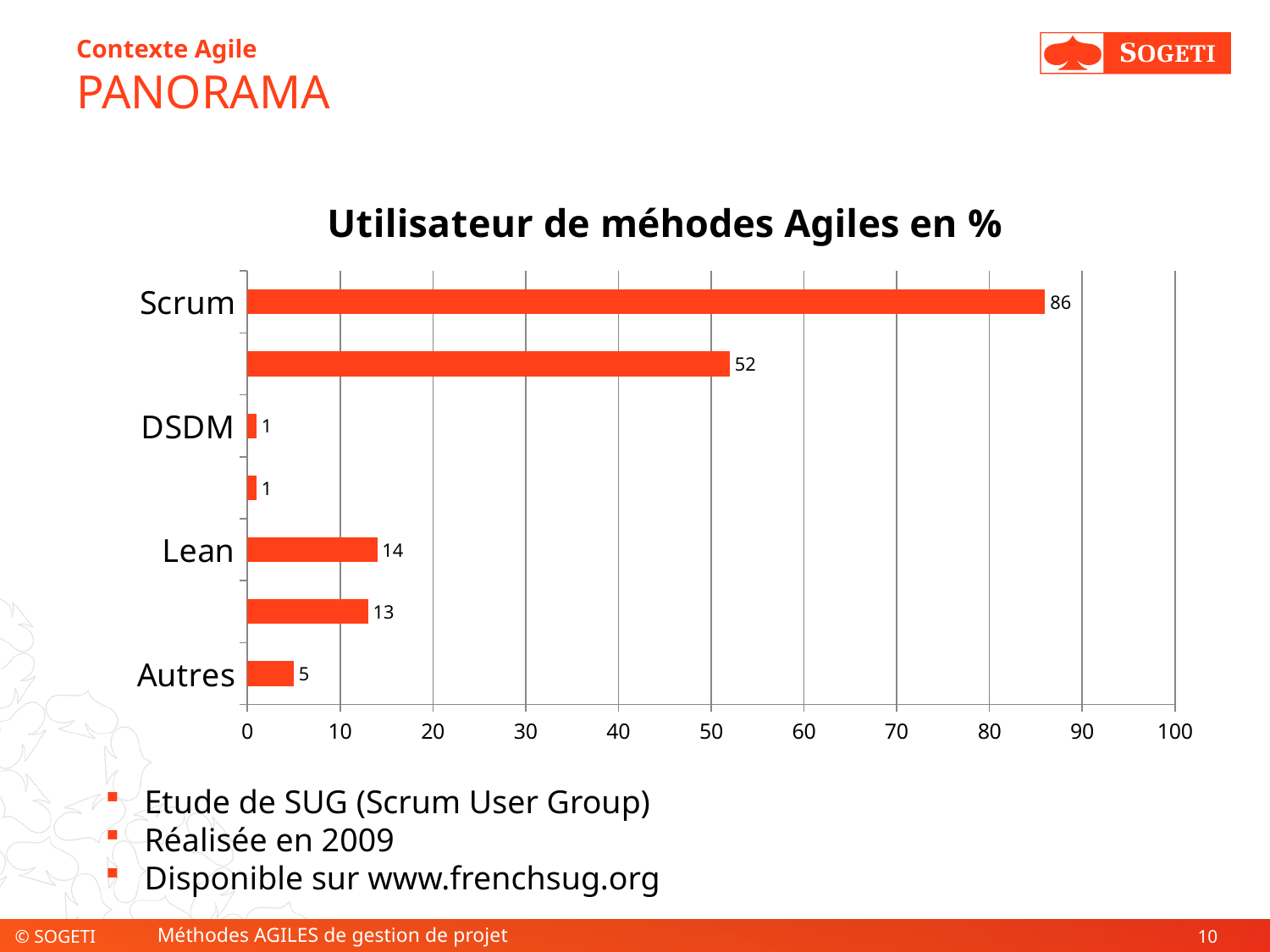
What is the difference between the values for Scrum and Lean? 72 Is the value for Scrum greater or less than 80? greater What kind of chart is shown on the slide? Bar chart What is the difference between the values for Lean and Autres? 9 Which category has the highest value? Scrum What is the value for Scrum? 86 What is the value for Autres? 5 What is the title of the chart? Utilisateur de méhodes Agiles en % What is the value for DSDM? 1 Which is larger, the value for Lean or the value for Autres? Lean What is the value for Lean? 14 How many bars are plotted in the chart? 7